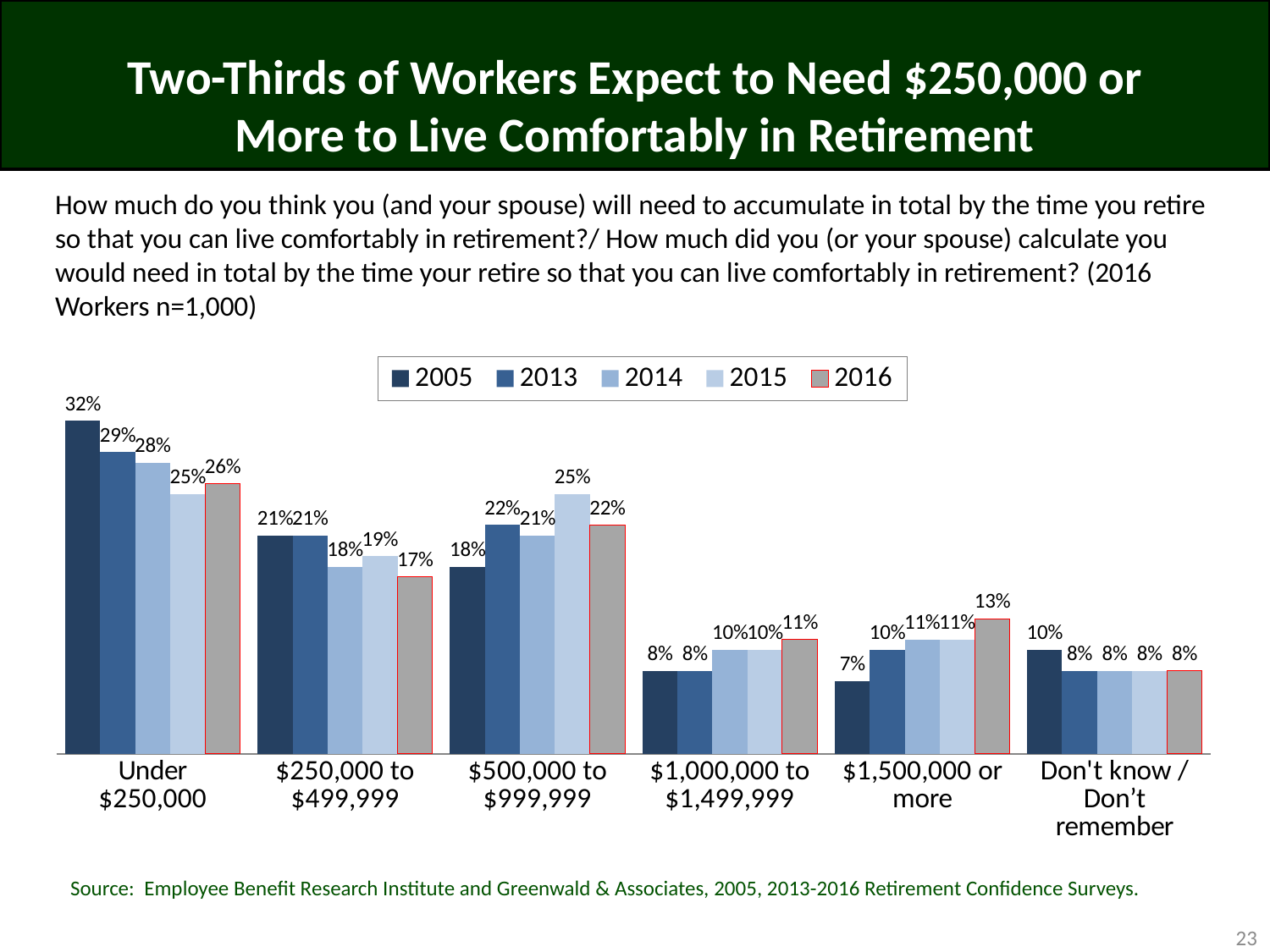
How many series does the legend list? 5 What is the value for 2005 in the "$1,500,000 or more" category? 7% What is the difference between the 2005 and 2016 values in the "Under $250,000" category? 6 percentage points What is the value for 2015 in the "$500,000 to $999,999" category? 25% Which series is drawn with a red outline around its bars? 2016 Does the value for the "$1,500,000 or more" category rise or fall from 2005 to 2016? Rise How many categories are shown on the x axis? 6 Which category has the highest value for the 2005 series? Under $250,000 What kind of chart is shown on the slide? Bar chart Which is larger in the "$250,000 to $499,999" category: the 2015 value or the 2016 value? 2015 What percentage of workers in 2016 expected to need under $250,000? 26% Which year has the lowest value in the "Under $250,000" category? 2015